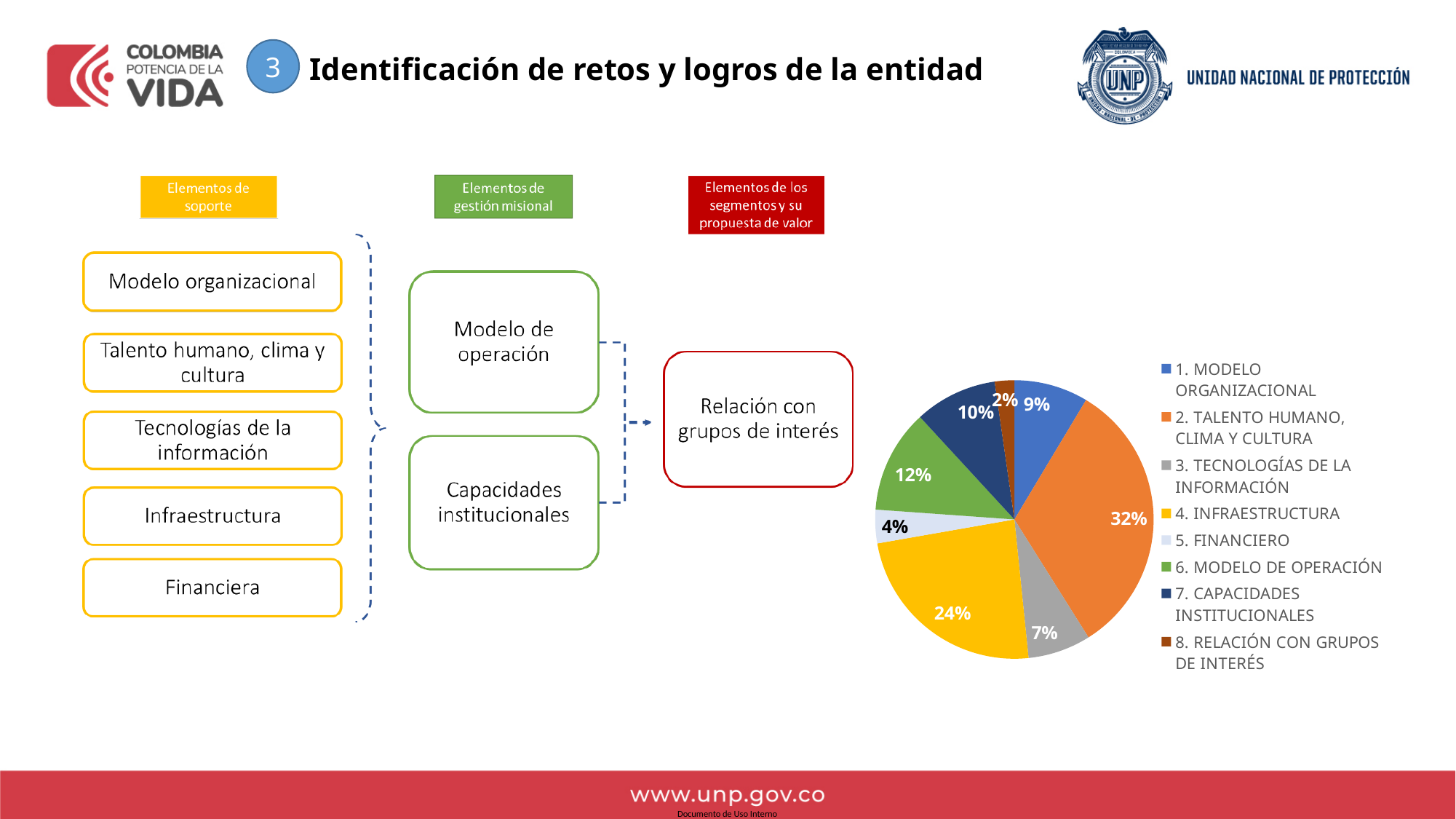
What is the difference between the shares of '4. INFRAESTRUCTURA' and '1. MODELO ORGANIZACIONAL'? 15% What kind of chart is shown on the slide? pie chart Which category has the largest slice in the pie chart? 2. TALENTO HUMANO, CLIMA Y CULTURA Which category has the smallest slice in the pie chart? 8. RELACIÓN CON GRUPOS DE INTERÉS What is the value shown for '1. MODELO ORGANIZACIONAL' in the pie chart? 9% What is the value shown for '5. FINANCIERO' in the pie chart? 4% How many slices does the pie chart have? 8 What share of the pie does '2. TALENTO HUMANO, CLIMA Y CULTURA' represent? 32% What share of the pie does '4. INFRAESTRUCTURA' represent? 24% What colour is the slice for '4. INFRAESTRUCTURA' in the pie chart? yellow Which is larger in the pie chart: '7. CAPACIDADES INSTITUCIONALES' or '3. TECNOLOGÍAS DE LA INFORMACIÓN'? 7. CAPACIDADES INSTITUCIONALES What is the value shown for '6. MODELO DE OPERACIÓN' in the pie chart? 12%